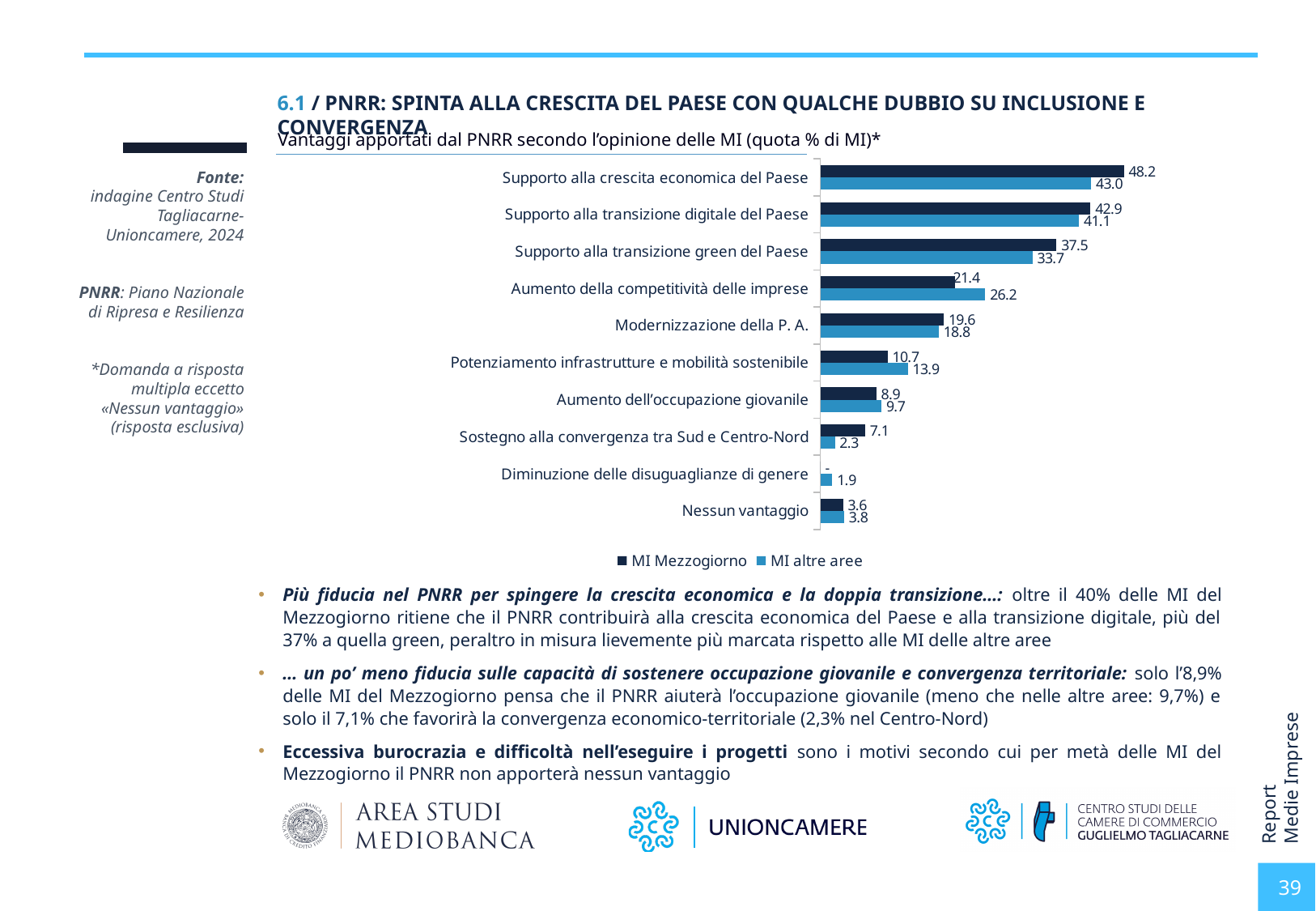
How many categories are shown in the chart? 10 For "Aumento della competitività delle imprese", which series has the larger value, MI Mezzogiorno or MI altre aree? MI altre aree How many series does the legend list? 2 What is the difference between the MI Mezzogiorno and MI altre aree values for "Supporto alla crescita economica del Paese"? 5.2 What are the two series listed in the chart legend? MI Mezzogiorno and MI altre aree What is the value for MI altre aree for "Supporto alla transizione green del Paese"? 33.7 Which category has the highest value for MI Mezzogiorno? Supporto alla crescita economica del Paese What is the value for MI Mezzogiorno for "Nessun vantaggio"? 3.6 What is the value for MI Mezzogiorno for "Supporto alla crescita economica del Paese"? 48.2 What is the value for MI altre aree for "Sostegno alla convergenza tra Sud e Centro-Nord"? 2.3 Which category has the lowest value for MI altre aree? Diminuzione delle disuguaglianze di genere What kind of chart is shown on the slide? Bar chart